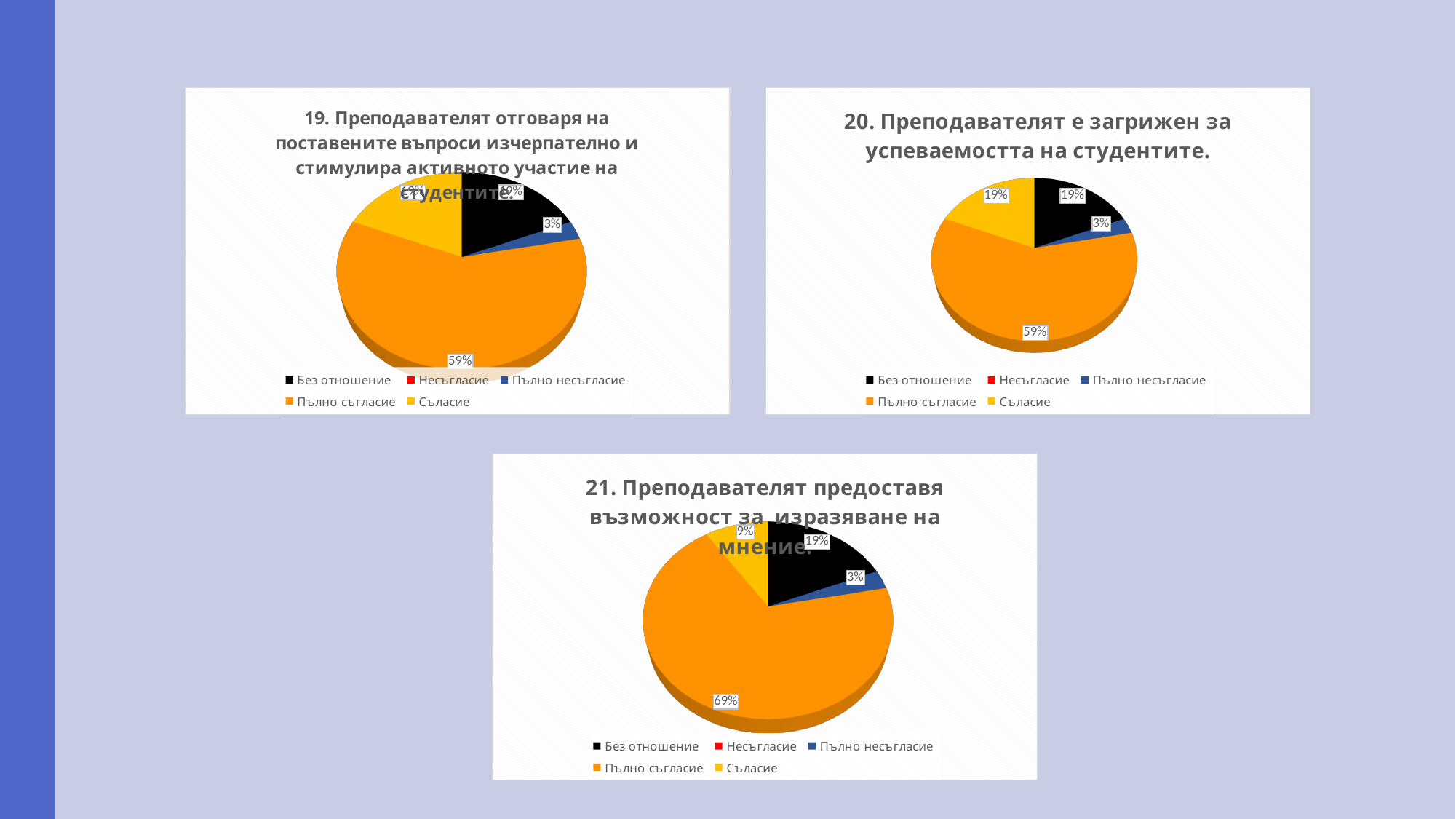
In the chart titled "21. Преподавателят предоставя възможност за изразяване на мнение.", what is the difference between the Пълно съгласие and Без отношение percentages? 50% In the chart titled "21. Преподавателят предоставя възможност за изразяване на мнение.", which category has the largest slice? Пълно съгласие In the chart titled "20. Преподавателят е загрижен за успеваемостта на студентите.", which category has the largest slice? Пълно съгласие How many entries does the legend list in the chart titled "20. Преподавателят е загрижен за успеваемостта на студентите."? 5 In the chart titled "20. Преподавателят е загрижен за успеваемостта на студентите.", what percentage is shown for Съгласие? 19% In the chart titled "19. Преподавателят отговаря на поставените въпроси изчерпателно и стимулира активното участие на студентите.", what percentage is shown for Без отношение? 19% In the chart titled "20. Преподавателят е загрижен за успеваемостта на студентите.", which is larger: Без отношение or Пълно несъгласие? Без отношение In the chart titled "20. Преподавателят е загрижен за успеваемостта на студентите.", what percentage is shown for Пълно съгласие? 59% In the chart titled "21. Преподавателят предоставя възможност за изразяване на мнение.", what percentage is shown for Съгласие? 9% In the chart titled "21. Преподавателят предоставя възможност за изразяване на мнение.", what percentage is shown for Пълно съгласие? 69% What type of chart is used for "21. Преподавателят предоставя възможност за изразяване на мнение."? Pie chart In the chart titled "19. Преподавателят отговаря на поставените въпроси изчерпателно и стимулира активното участие на студентите.", what percentage is shown for Пълно несъгласие? 3%